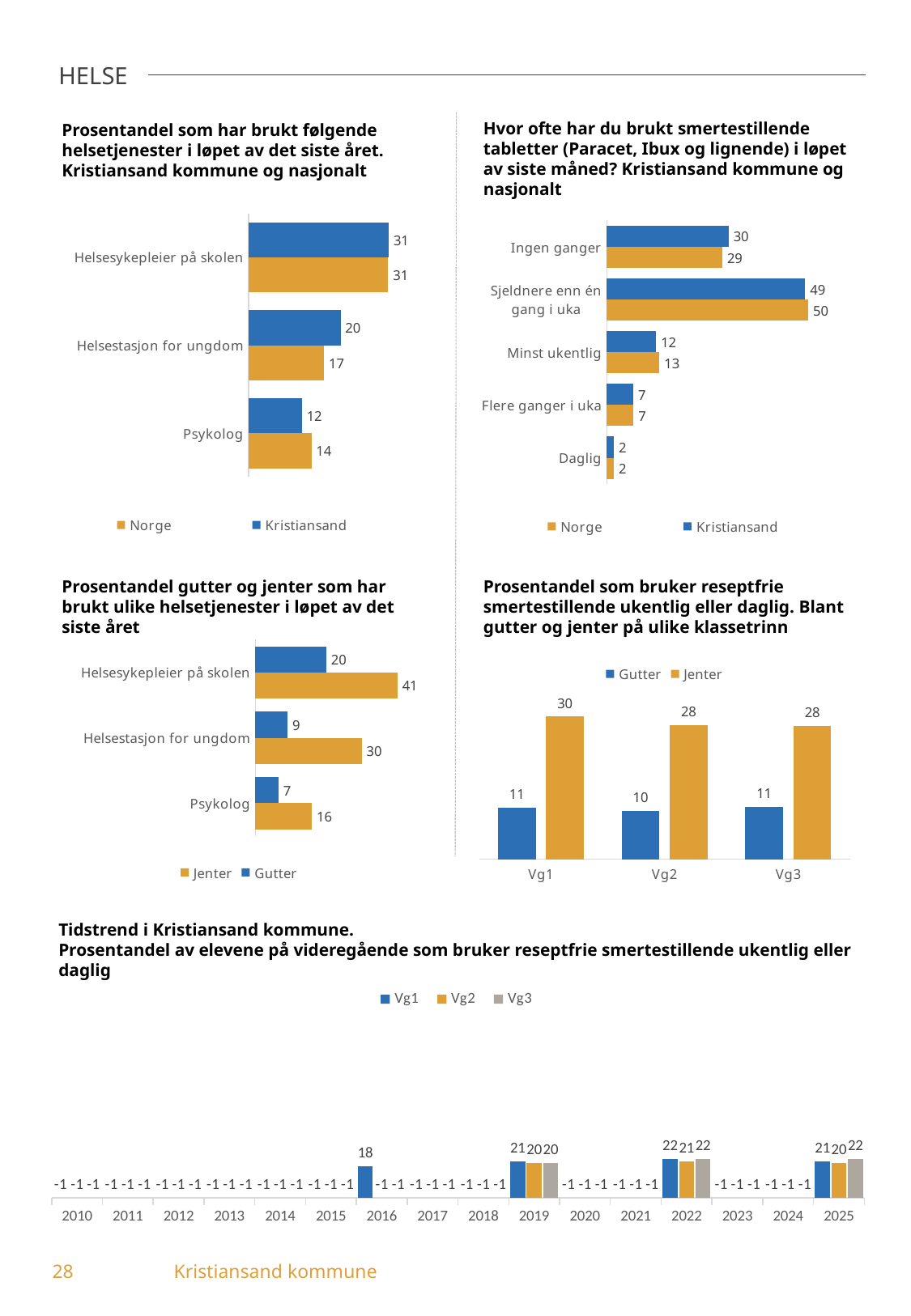
How many categories are shown in the chart 'Hvor ofte har du brukt smertestillende tabletter'? 5 In the chart 'Prosentandel som har brukt følgende helsetjenester i løpet av det siste året', what is the value for Kristiansand for Helsestasjon for ungdom? 20 In the chart 'Prosentandel gutter og jenter som har brukt ulike helsetjenester', which is larger for Helsestasjon for ungdom, Gutter or Jenter? Jenter In the chart 'Prosentandel som bruker reseptfrie smertestillende ukentlig eller daglig', what is the value for Gutter in Vg2? 10 In the chart 'Prosentandel som bruker reseptfrie smertestillende ukentlig eller daglig', what is the difference between Jenter and Gutter in Vg1? 19 In the chart 'Hvor ofte har du brukt smertestillende tabletter', which category has the highest value for Kristiansand? Sjeldnere enn én gang i uka In the chart 'Hvor ofte har du brukt smertestillende tabletter', what is the Norge value for Minst ukentlig? 13 In the chart 'Tidstrend i Kristiansand kommune', what is the value for Vg3 in 2025? 22 In the chart 'Prosentandel som har brukt følgende helsetjenester i løpet av det siste året', what is the difference between the Norge and Kristiansand values for Psykolog? 2 What kind of chart is the chart 'Prosentandel som bruker reseptfrie smertestillende ukentlig eller daglig'? Bar chart In the chart 'Prosentandel gutter og jenter som har brukt ulike helsetjenester', what is the value for Jenter for Helsesykepleier på skolen? 41 How many series does the legend list in the chart 'Tidstrend i Kristiansand kommune'? 3